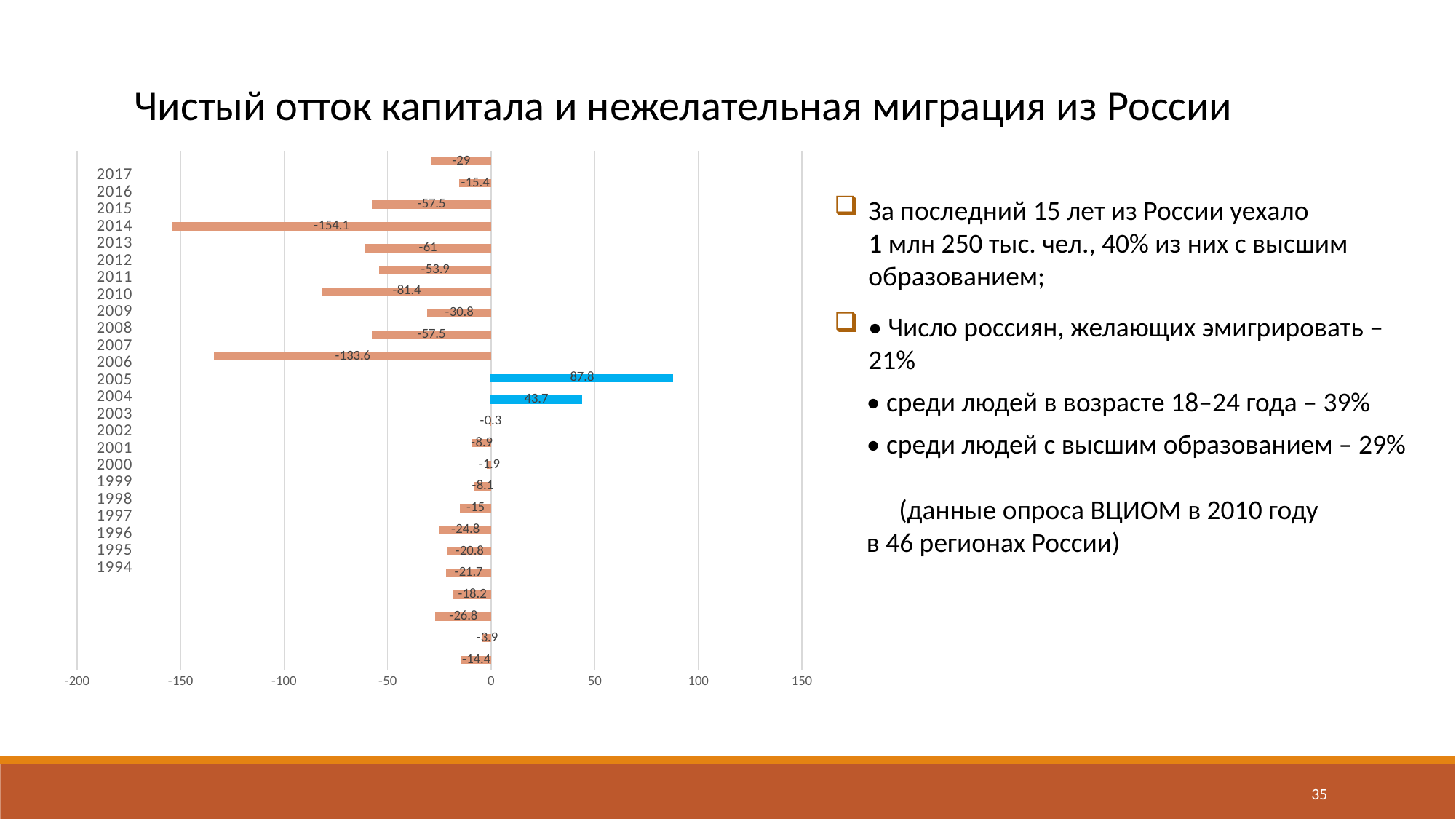
What is the difference between the two lowest values, -154.1 and -133.6? 20.5 How many bars are plotted in the chart? 24 What kind of chart is shown on the slide? bar chart What is the title of the slide containing the chart? Чистый отток капитала и нежелательная миграция из России What is the difference between the two positive values, 87.8 and 43.7? 44.1 Is the value of the longest negative bar greater or less than -150? less What is the highest value shown in the chart? 87.8 What colour are the bars with positive values? blue What is the value of the topmost bar in the chart? -29 Which of the two positive bars is larger, 87.8 or 43.7? 87.8 How many bars in the chart have positive values? 2 What is the lowest value shown in the chart? -154.1